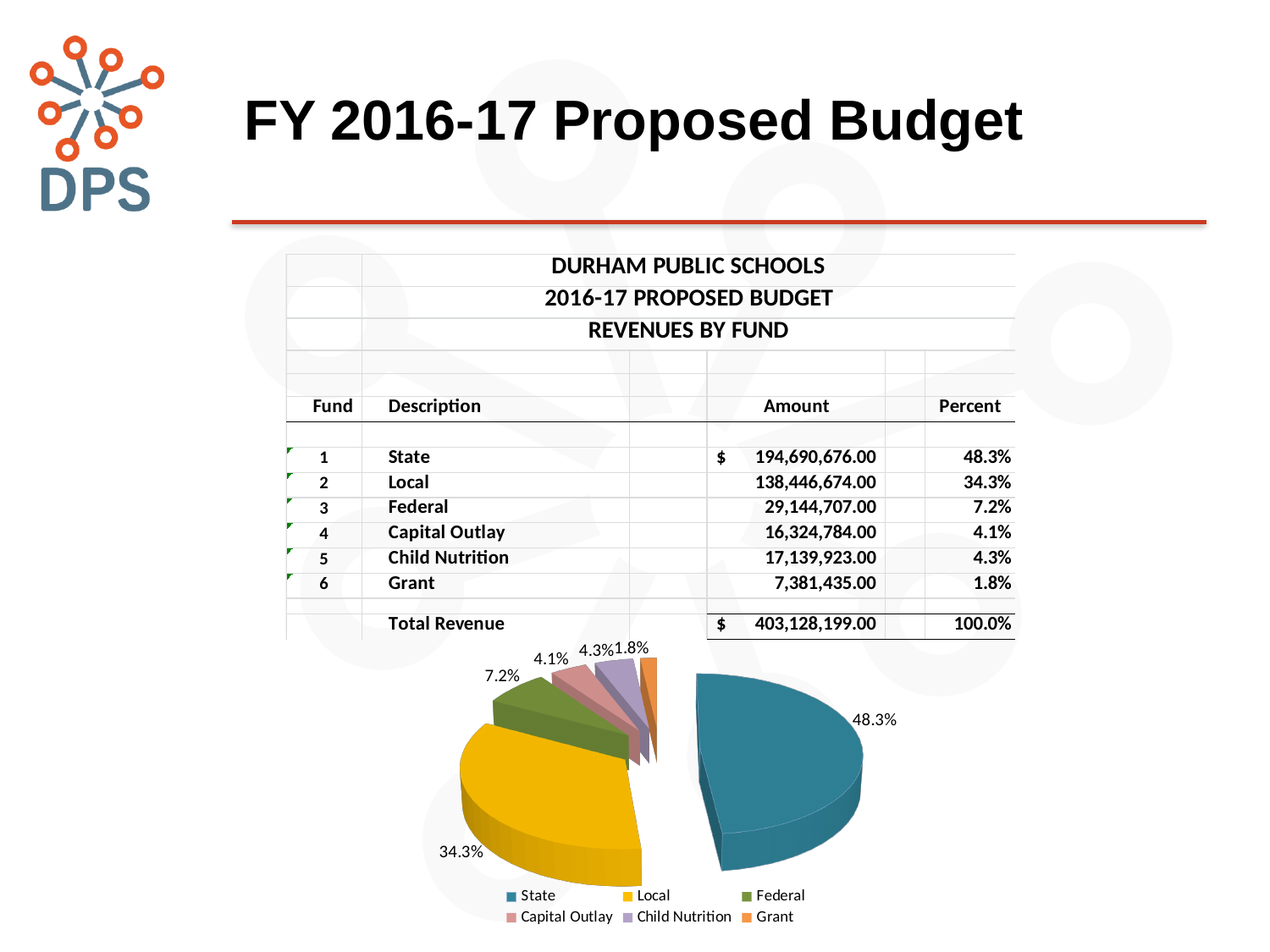
What share of the pie chart does State represent? 48.3% What share of the pie chart does Child Nutrition represent? 4.3% Which slice is larger in the pie chart, Capital Outlay or Child Nutrition? Child Nutrition What colour is the State slice in the pie chart? Teal blue Which category has the smallest slice in the pie chart? Grant What share of the pie chart does Grant represent? 1.8% What share of the pie chart does Federal represent? 7.2% How many slices does the pie chart have? 6 What share of the pie chart does Local represent? 34.3% What kind of chart is shown on the slide? Pie chart Which category has the largest slice in the pie chart? State What is the difference in percentage points between the State and Local slices? 14.0%